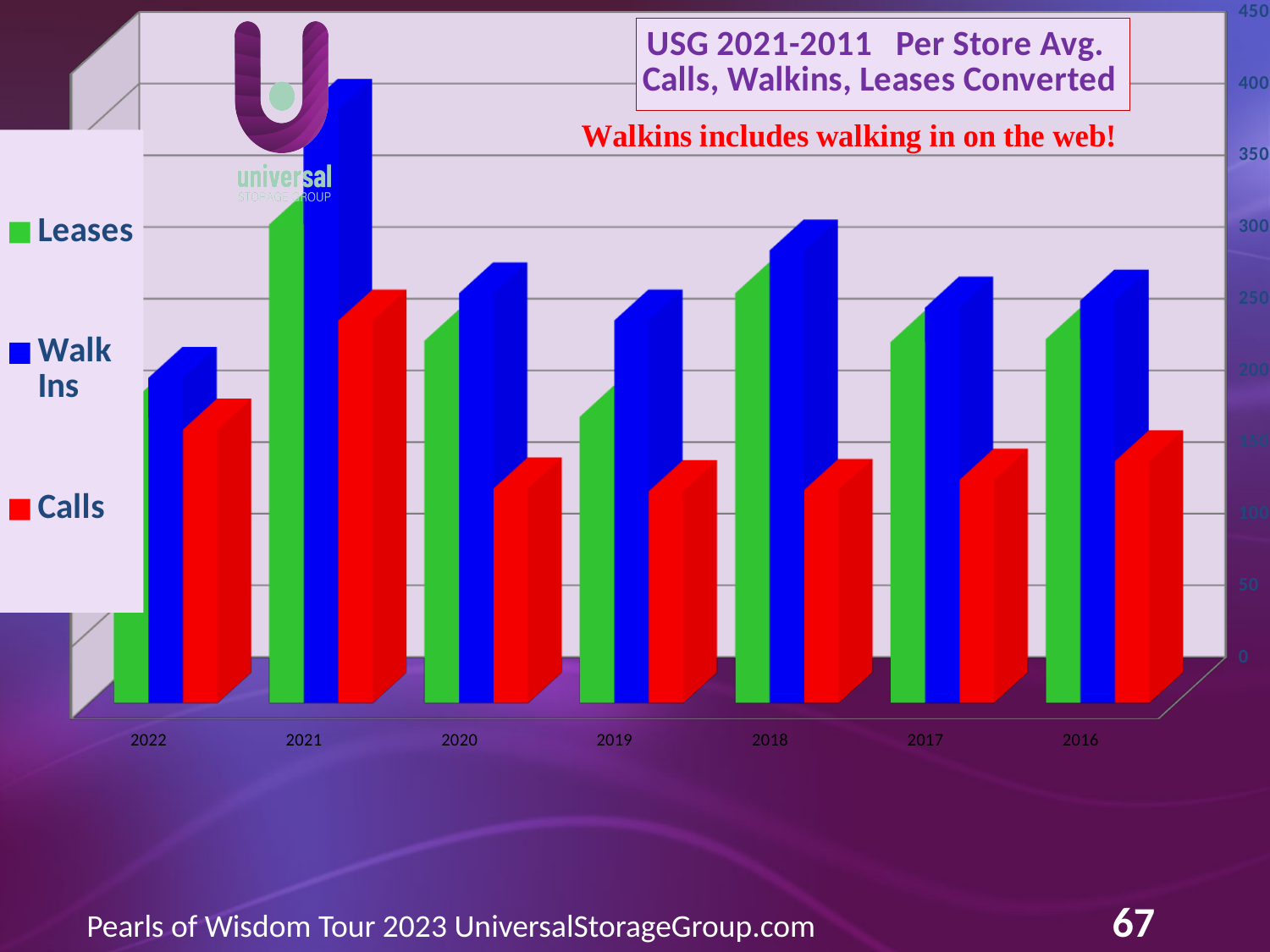
What kind of chart is shown on the slide? Bar chart Is the Calls value for 2020 greater or less than 200? less How many series does the chart legend list? 3 How many years are shown along the x axis of the chart? 7 In which year is the Walk Ins bar highest? 2021 Which year has the larger Calls value, 2021 or 2016? 2021 Is the Walk Ins value for 2021 greater or less than 350? greater In which year is the Walk Ins bar lowest? 2022 Is the Walk Ins value for 2022 greater or less than 300? less Which is larger in 2021, the Walk Ins bar or the Calls bar? Walk Ins In which year is the Calls bar highest? 2021 Which series is shown in blue in the chart legend? Walk Ins